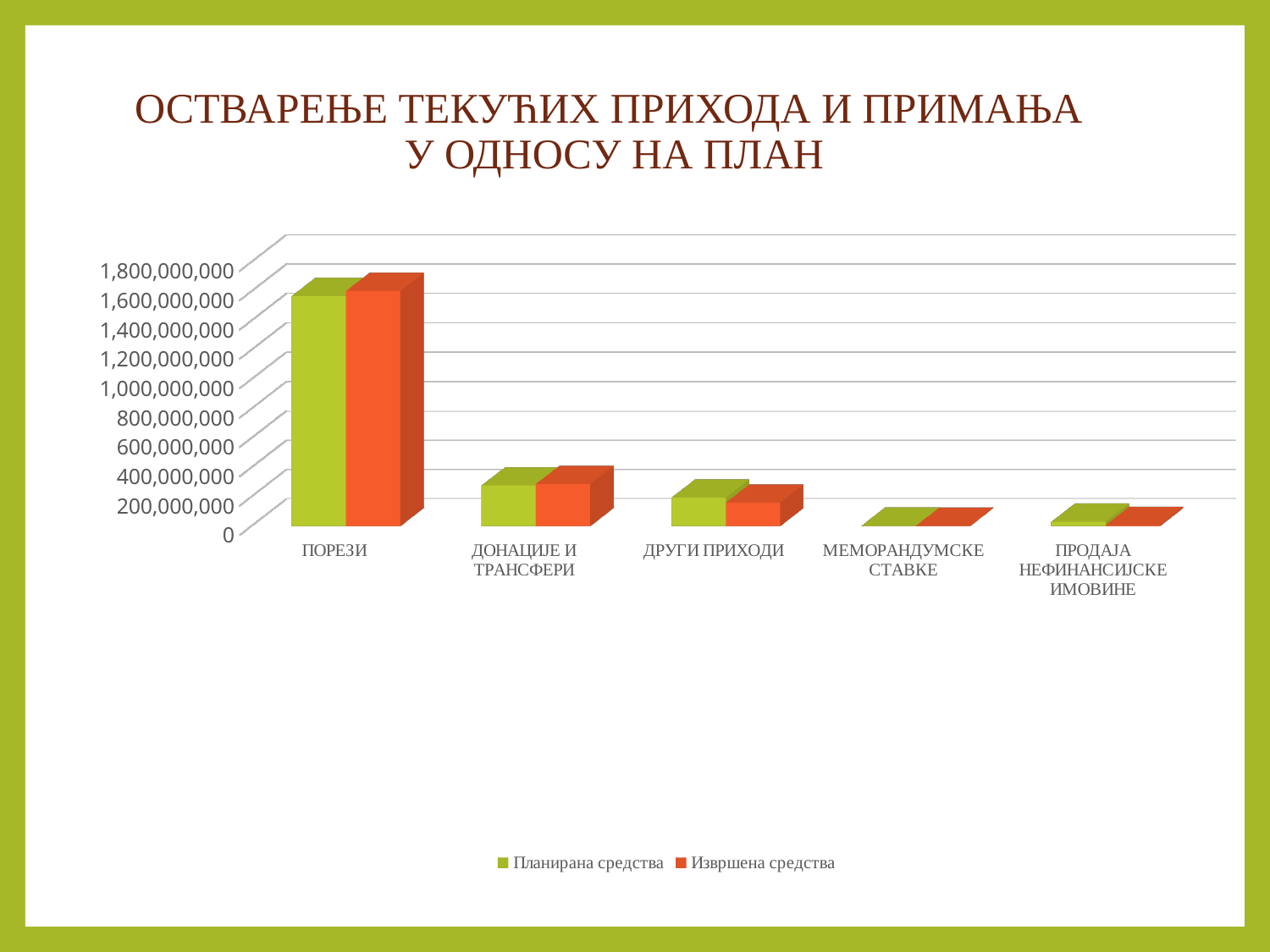
For ДРУГИ ПРИХОДИ, which is larger: Планирана средства or Извршена средства? Планирана средства Which category has the highest value for Планирана средства? ПОРЕЗИ Is the Извршена средства value for ДОНАЦИЈЕ И ТРАНСФЕРИ greater or less than 600,000,000? less How many categories are shown on the x axis of the chart? 5 How many series does the chart legend list? 2 Do the values generally rise or fall moving from left to right along the x axis? fall Which has the larger Планирана средства value: ДОНАЦИЈЕ И ТРАНСФЕРИ or ДРУГИ ПРИХОДИ? ДОНАЦИЈЕ И ТРАНСФЕРИ Is the Планирана средства value for ПОРЕЗИ greater or less than 1,000,000,000? greater Is the Извршена средства value for ДРУГИ ПРИХОДИ greater or less than 400,000,000? less Which colour represents Извршена средства in the chart? orange What kind of chart is shown on the slide? bar chart